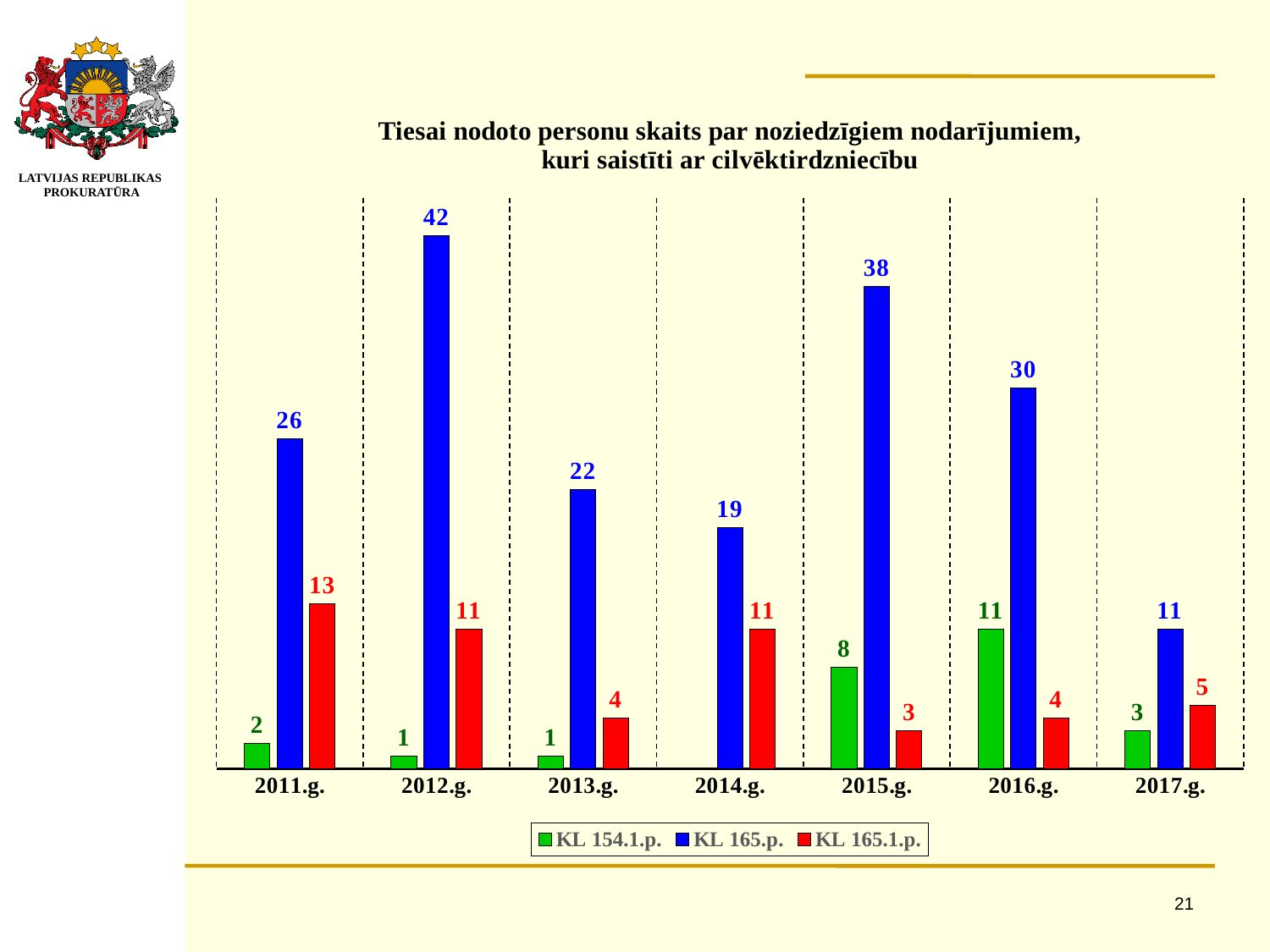
In which year is the KL 165.p. value highest? 2012.g. Which colour represents KL 165.1.p. in the legend? red In which year is the KL 165.p. value lowest? 2017.g. How many years are shown on the x axis? 7 What is the total of the three series in 2015.g.? 49 How many series does the legend list? 3 What kind of chart is shown on the slide? bar chart What is the value for KL 165.p. in 2012.g.? 42 Which is larger in 2013.g., KL 165.p. or KL 165.1.p.? KL 165.p. What is the value for KL 165.1.p. in 2011.g.? 13 What is the value for KL 154.1.p. in 2016.g.? 11 What is the difference between the KL 165.p. values in 2015.g. and 2016.g.? 8